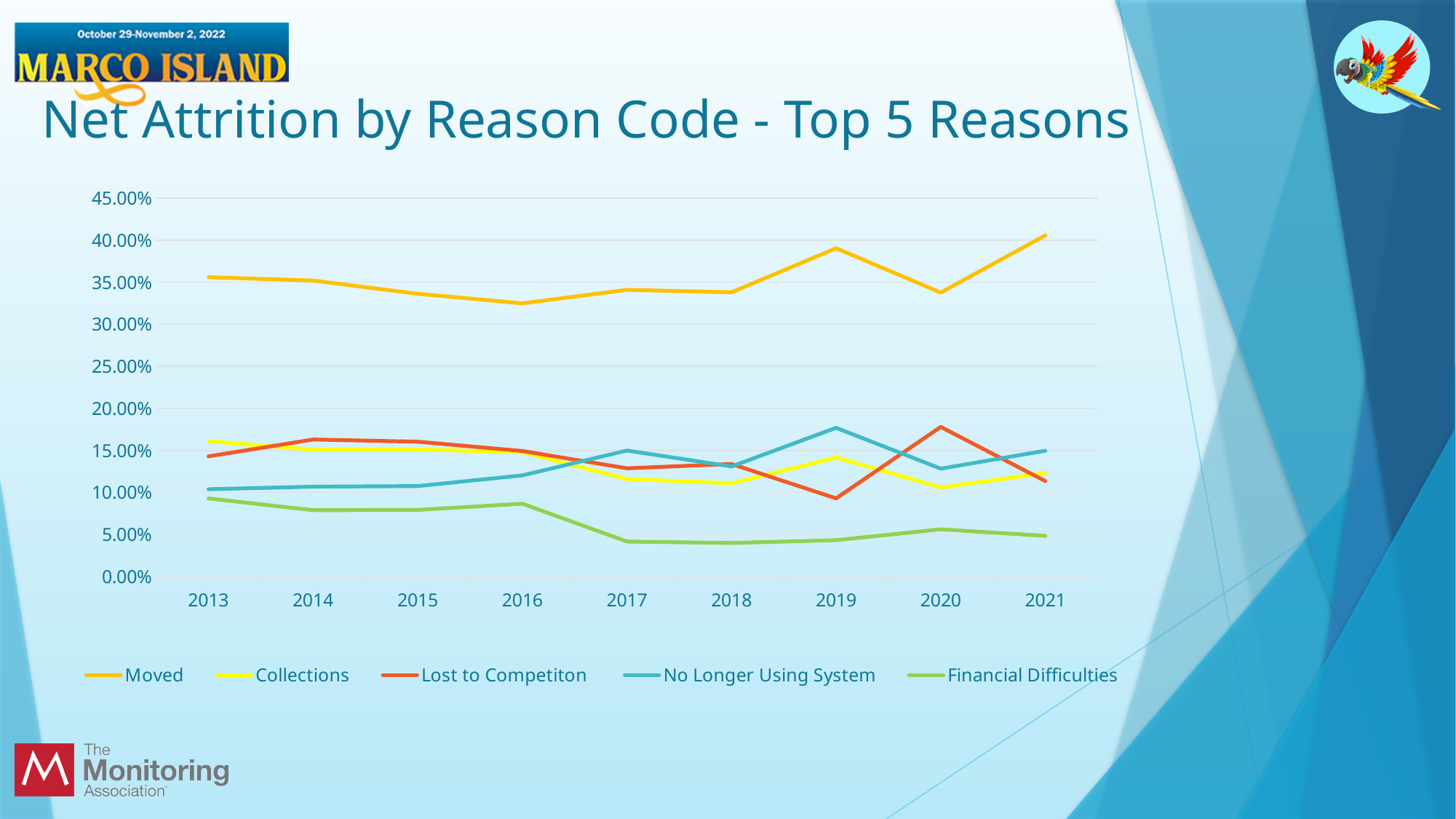
Is the value for Collections in 2018 greater or less than 15.00%? less How many years are shown along the x axis? 9 How many series does the legend list? 5 Is the value for No Longer Using System in 2019 greater or less than 15.00%? greater In which year does the Moved series reach its highest value? 2021 Is the value for Financial Difficulties in 2017 greater or less than 5.00%? less What is the title of the chart? Net Attrition by Reason Code - Top 5 Reasons Which reason code has the highest net attrition in 2021? Moved Which reason code has the lowest net attrition in 2021? Financial Difficulties Does the Moved series rise or fall from 2020 to 2021? rise What kind of chart is shown on the slide? line chart